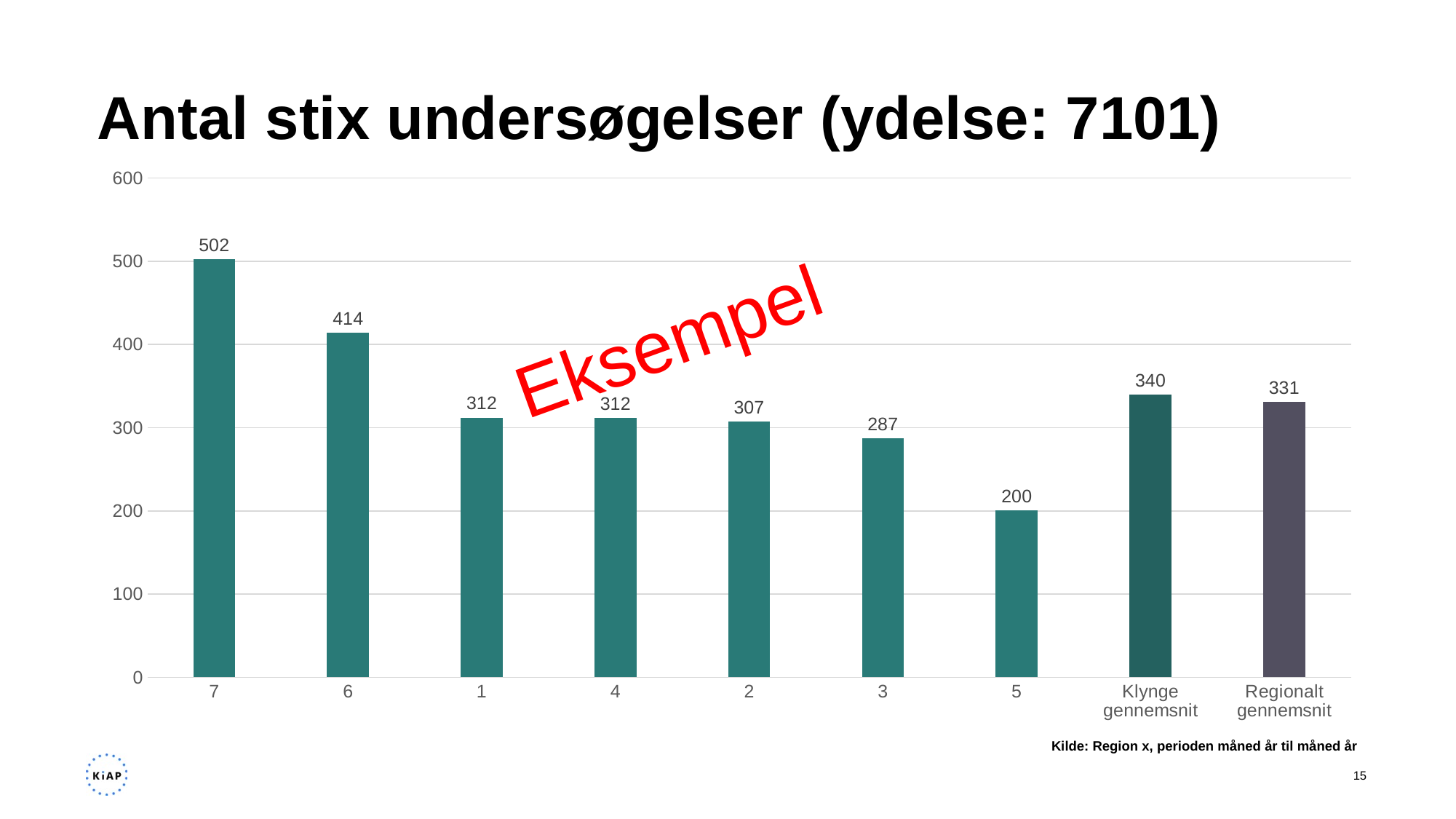
Which is larger, the value for category 2 or the value for category 3? 2 Which category has the highest value? 7 What is the value for Regionalt gennemsnit? 331 How many bars are shown in the chart? 9 What kind of chart is shown on the slide? bar chart Is the value for category 6 greater or less than 400? greater What is the difference between the values for category 7 and category 6? 88 What is the value for category 7? 502 What is the title of the chart? Antal stix undersøgelser (ydelse: 7101) What is the value for Klynge gennemsnit? 340 What is the difference between Klynge gennemsnit and Regionalt gennemsnit? 9 Which category has the lowest value? 5